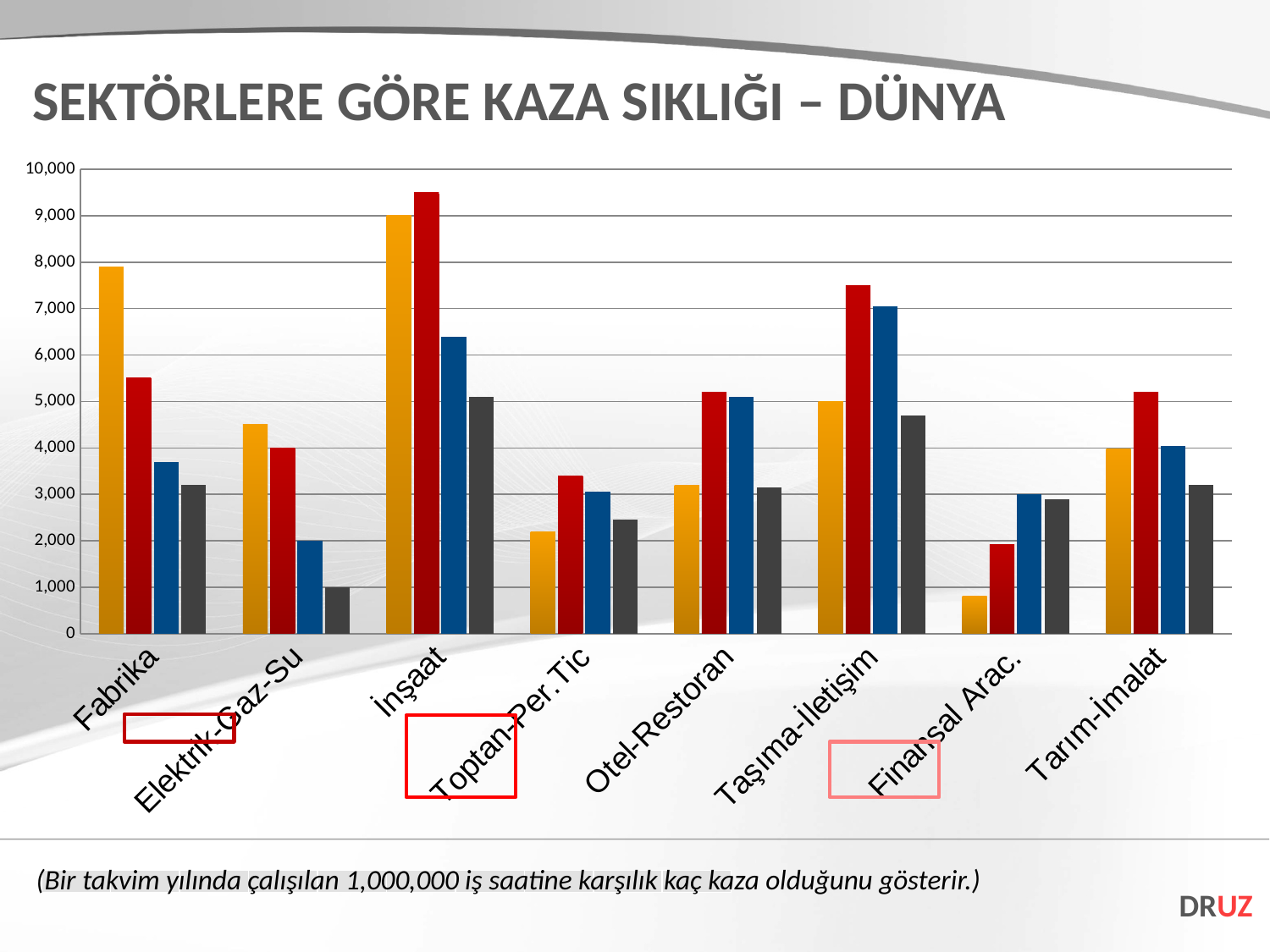
Is the blue bar for Taşıma-İletişim greater or less than 6,000? greater How many bars are shown for each sector category? 4 Which has the larger red bar: Taşıma-İletişim or Otel-Restoran? Taşıma-İletişim For Fabrika, which is larger: the orange bar or the red bar? the orange bar Is the orange bar for Fabrika greater or less than 7,000? greater What is the value of the dark gray bar for Elektrik-Gaz-Su? 1,000 Which sector has the shortest bar in the chart? Finansal Arac. How many sector categories are shown on the x axis? 8 What kind of chart is shown on the slide? bar chart What is the title of the chart on the slide? SEKTÖRLERE GÖRE KAZA SIKLIĞI – DÜNYA Which sector has the tallest bar in the chart? İnşaat